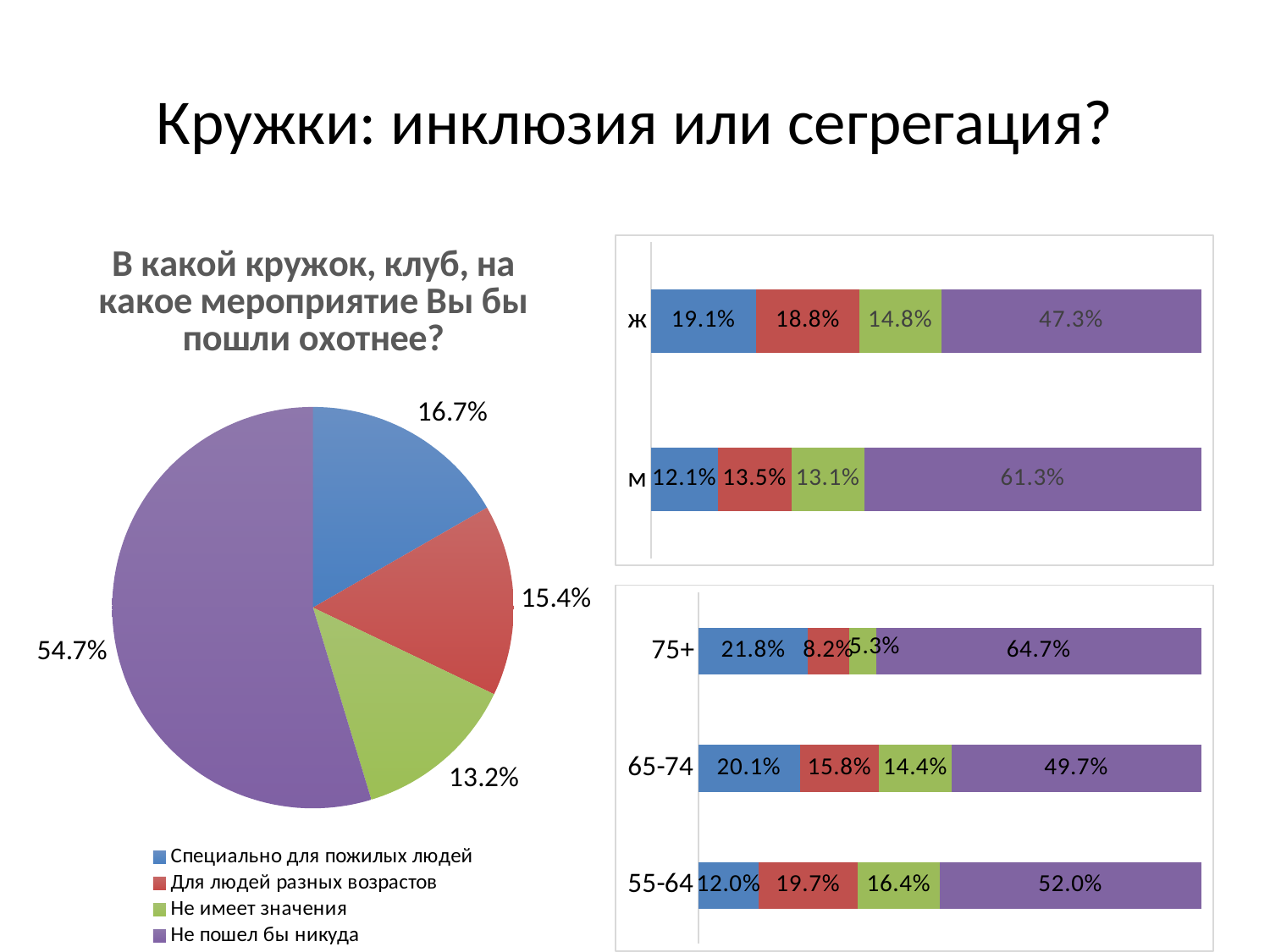
In the top-right bar chart, what is the difference between the purple segments for м and ж? 14.0% In the top-right bar chart, what is the value of the purple segment for the category м? 61.3% How many entries does the legend of the pie chart on the left list? 4 In the top-right bar chart, what is the value of the blue segment for the category ж? 19.1% In the pie chart on the left, which slice is the smallest? Не имеет значения (13.2%) In the bottom-right bar chart, what is the value of the purple segment for the 75+ group? 64.7% In the pie chart on the left, how many slices are there? 4 In the bottom-right bar chart, is the red segment for 55-64 larger or smaller than the red segment for 75+? Larger In the bottom-right bar chart, which age group has the largest blue segment? 75+ (21.8%) In the pie chart on the left, what share is shown for the blue slice 'Специально для пожилых людей'? 16.7% In the pie chart on the left, what share is labelled for the purple slice 'Не пошел бы никуда'? 54.7% What kind of chart is shown in the top-right panel with the categories ж and м? Stacked bar chart